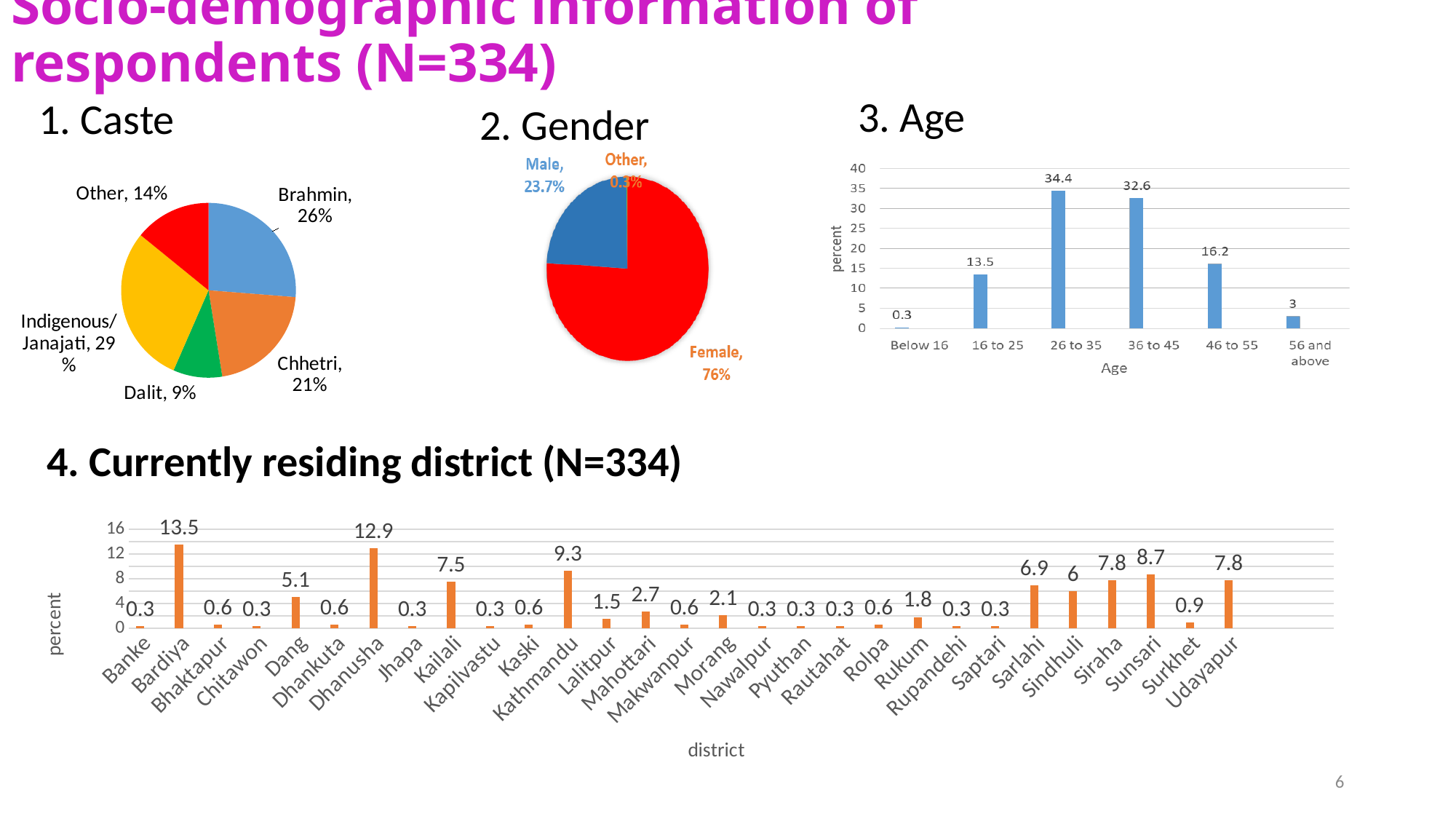
In the Gender pie chart, what percentage of respondents are male? 23.7% In the Currently residing district chart, which is larger, the value for Sunsari or the value for Siraha? Sunsari In the Age chart, what is the difference between the 26 to 35 and 36 to 45 age groups? 1.8 In the Caste pie chart, what share of respondents are Brahmin? 26% In the Age chart, what is the value for the 26 to 35 age group? 34.4 In the Age chart, how many age groups are shown on the x axis? 6 In the Age chart, which age group has the lowest percentage? Below 16 In the Currently residing district chart, what is the value for Kathmandu? 9.3 In the Caste pie chart, which caste group has the largest share? Indigenous/Janajati In the Currently residing district chart, which district has the highest percentage? Bardiya In the Caste pie chart, how many slices are there? 5 In the Gender pie chart, what percentage of respondents are female? 76%